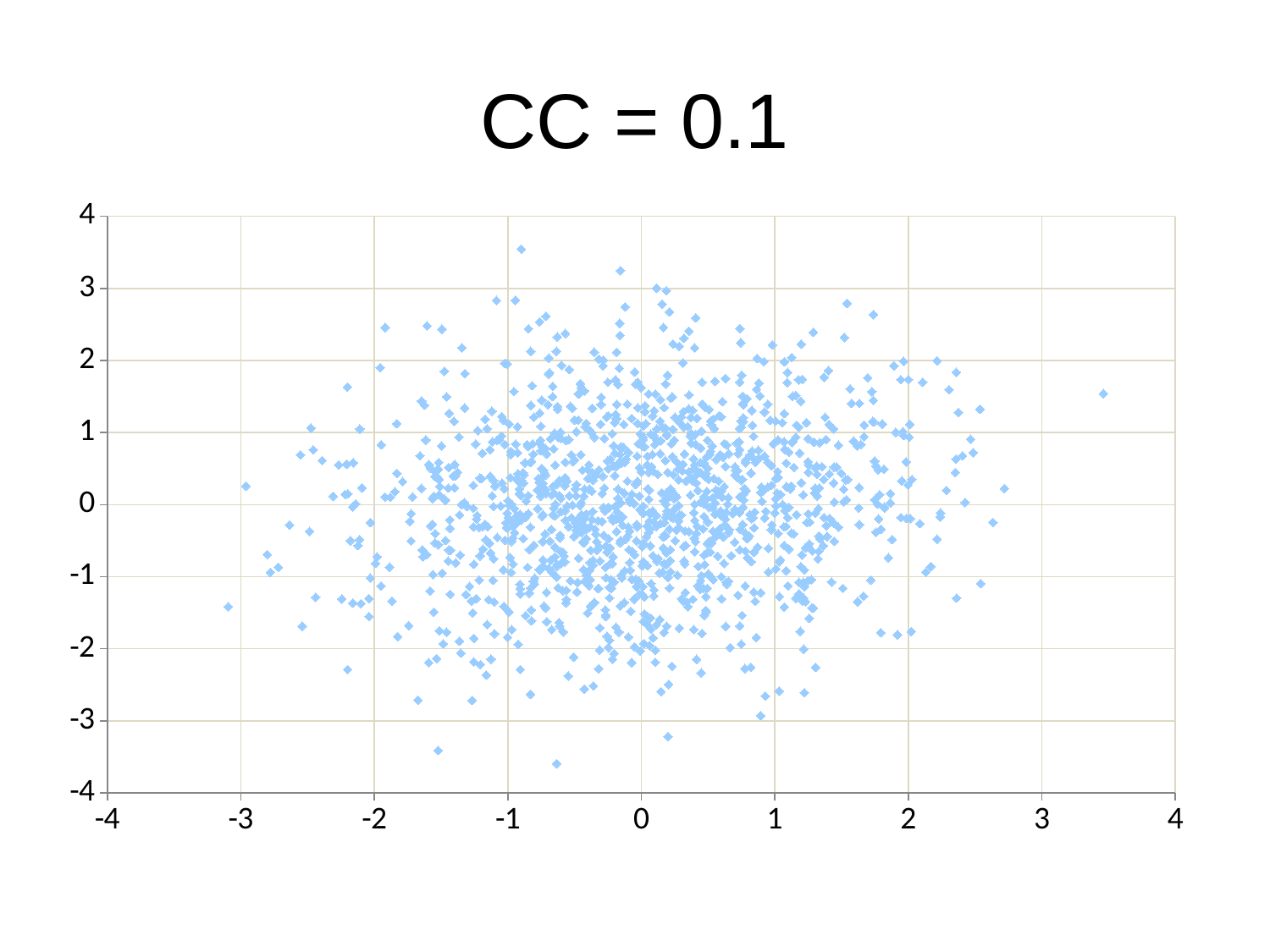
What kind of chart is shown on the slide? scatter plot What are the lowest and highest values shown on the x axis? -4 and 4 Is the y value of the highest point greater or less than 3? greater Is the y value of the lowest point greater or less than -3? less What is the title of the chart? CC = 0.1 Is the y value of the rightmost point greater or less than 1? greater